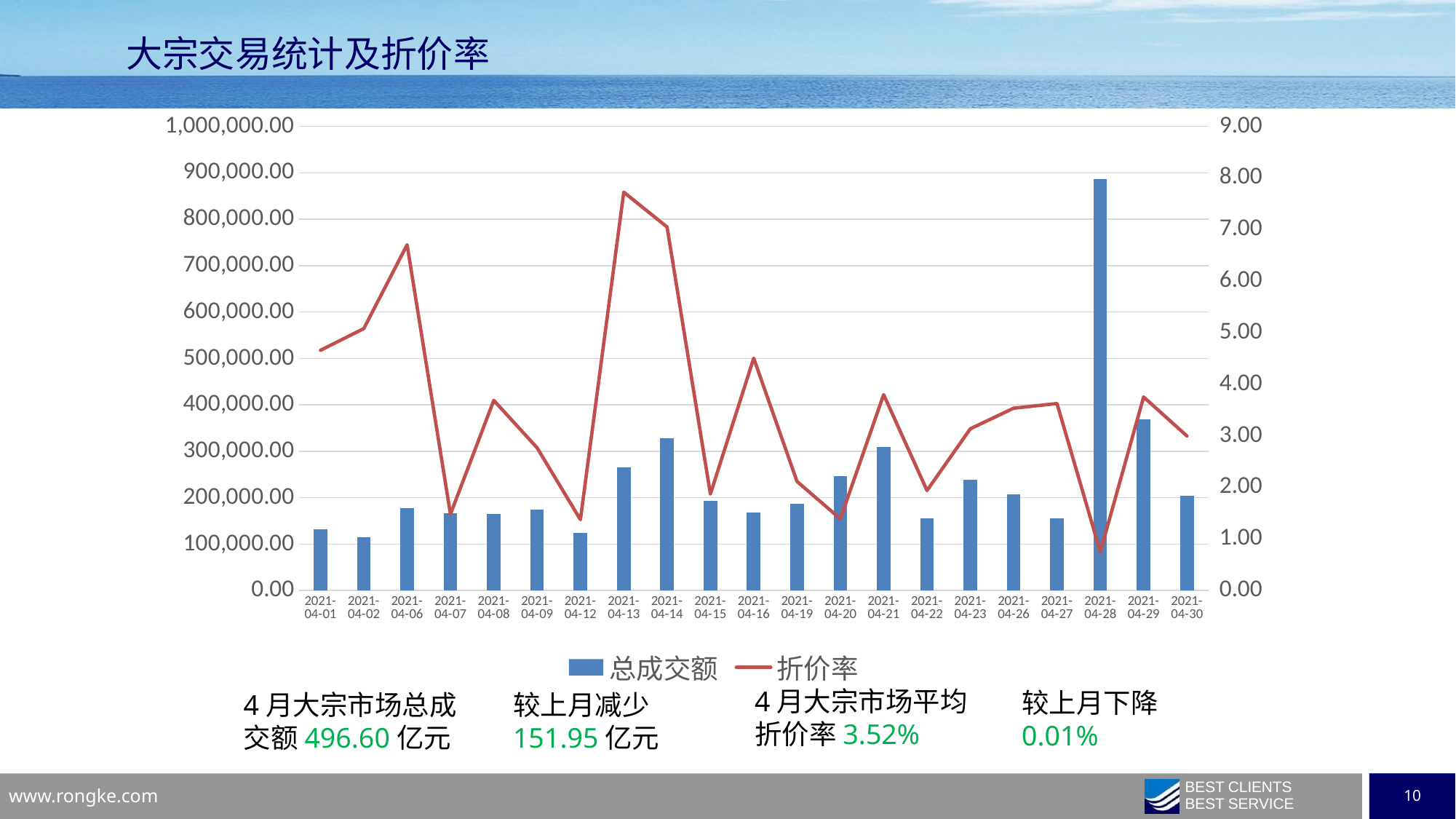
Is the 折价率 value for 2021-04-13 greater or less than 7.00? greater Which has the larger 总成交额 bar, 2021-04-29 or 2021-04-14? 2021-04-29 On which date does the 折价率 line reach its lowest point? 2021-04-28 What kind of chart is shown on the slide? A combined bar and line chart Is the 总成交额 bar for 2021-04-28 greater or less than 800,000.00? greater How many dates are shown along the x axis of the chart? 21 On which date does the 折价率 line reach its highest point? 2021-04-13 What are the two series named in the chart legend? 总成交额 and 折价率 Is the 折价率 value for 2021-04-07 greater or less than 2.00? less Which date has the highest 总成交额 bar? 2021-04-28 How many series does the chart legend list? 2